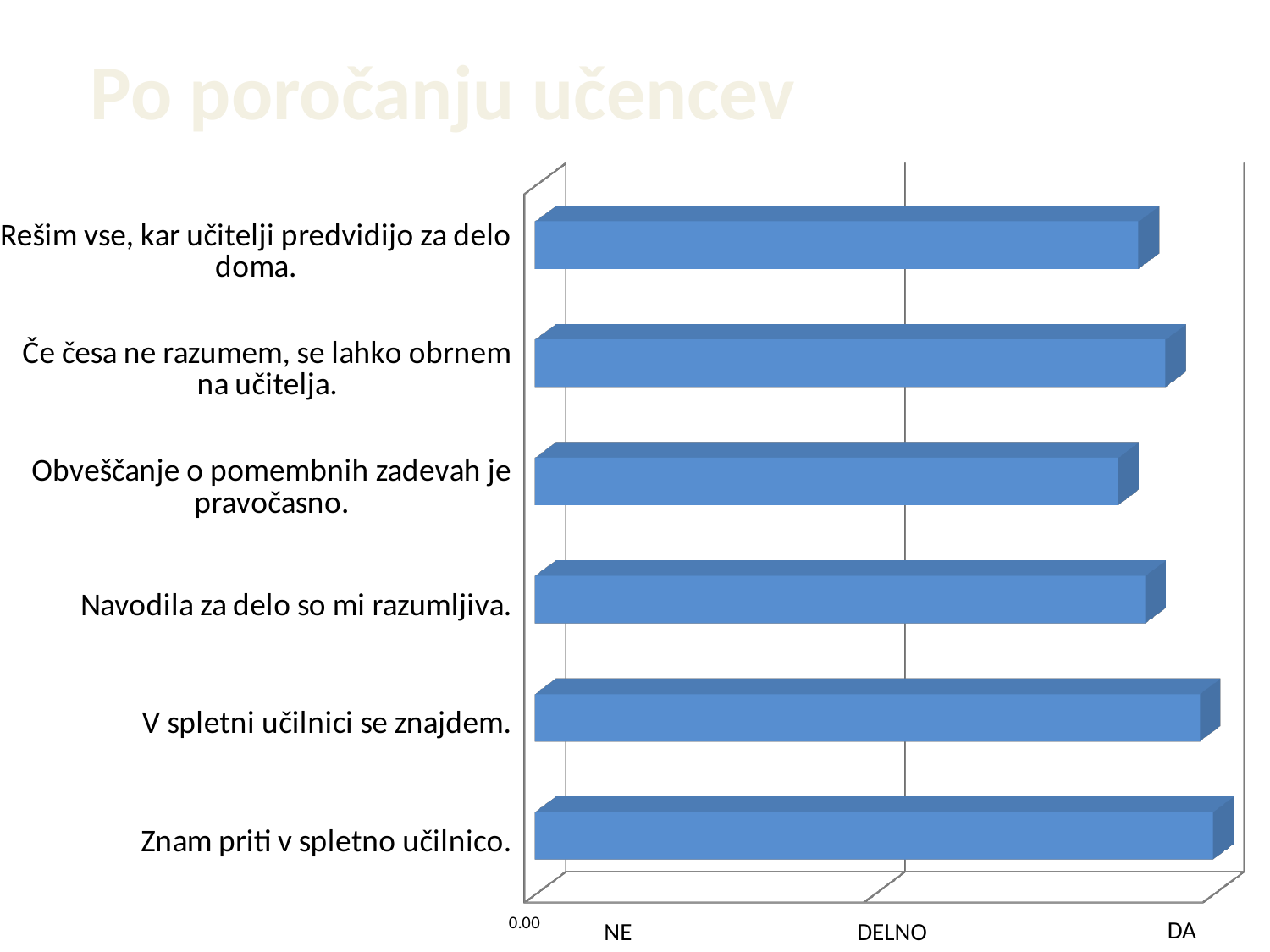
What kind of chart is shown on the slide? bar chart Which bar is longer: "Znam priti v spletno učilnico." or "Obveščanje o pomembnih zadevah je pravočasno."? Znam priti v spletno učilnico. Which statement has the longest bar in the chart? Znam priti v spletno učilnico. What are the three labels shown along the horizontal axis of the chart? NE, DELNO, DA How many categories (statements) are plotted in the chart? 6 Is the value for "Rešim vse, kar učitelji predvidijo za delo doma." greater or less than the DELNO mark on the axis? greater Which statement has the shortest bar in the chart? Obveščanje o pomembnih zadevah je pravočasno. Which bar is longer: "V spletni učilnici se znajdem." or "Rešim vse, kar učitelji predvidijo za delo doma."? V spletni učilnici se znajdem. Is the value for "Obveščanje o pomembnih zadevah je pravočasno." greater or less than the DELNO mark on the axis? greater Which bar is longer: "Če česa ne razumem, se lahko obrnem na učitelja." or "Obveščanje o pomembnih zadevah je pravočasno."? Če česa ne razumem, se lahko obrnem na učitelja. What is the title of the slide above the chart? Po poročanju učencev